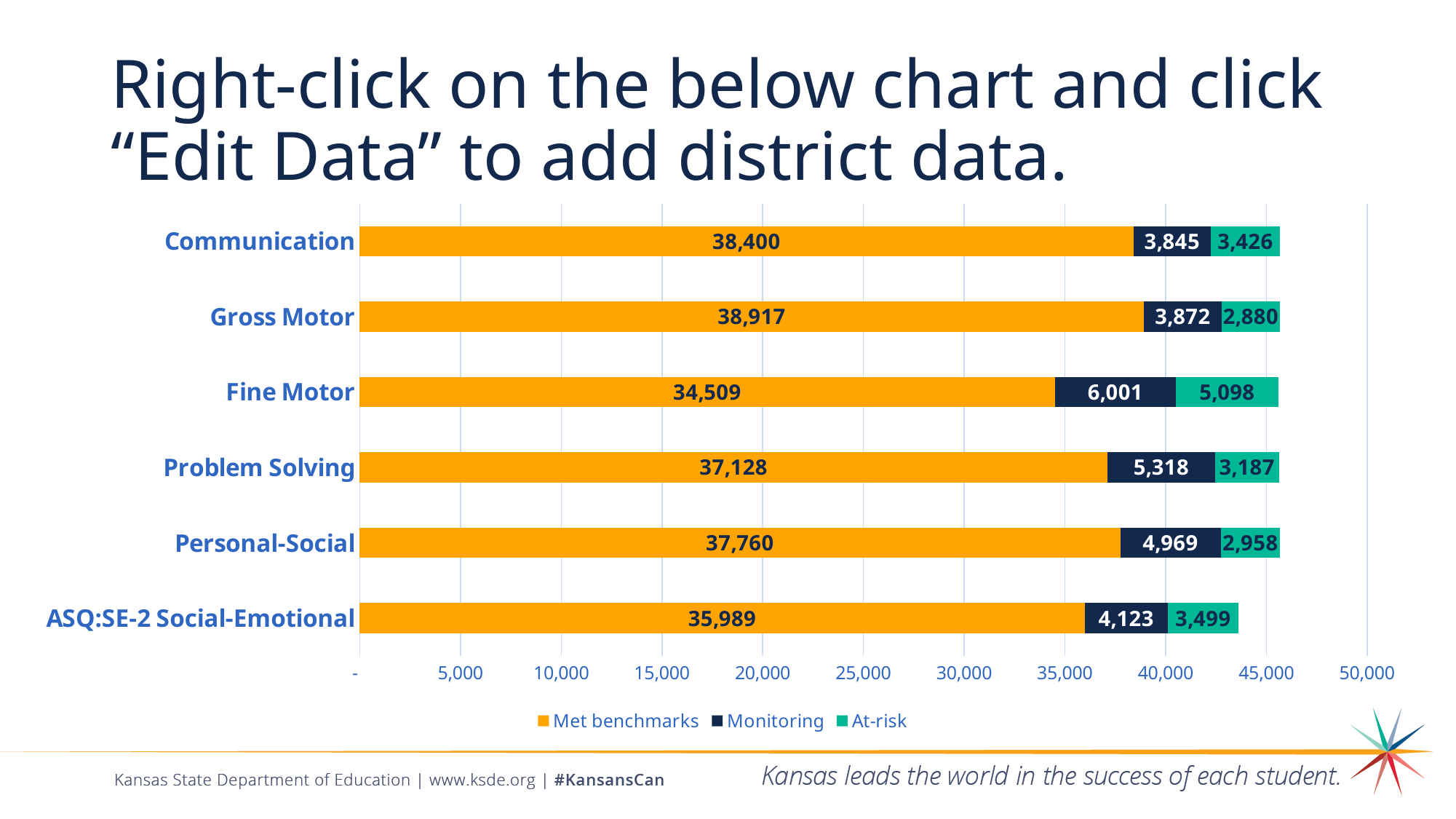
What is the Met benchmarks value for Fine Motor? 34,509 Which category has the lowest At-risk value? Gross Motor What is the At-risk value for ASQ:SE-2 Social-Emotional? 3,499 What is the Monitoring value for Problem Solving? 5,318 Which is larger, the At-risk value for Communication or the At-risk value for Personal-Social? Communication What is the total of the stacked bar for ASQ:SE-2 Social-Emotional? 43,611 What is the difference between the Monitoring values for Fine Motor and Communication? 2,156 How many series does the legend list? 3 What type of chart is shown on the slide? Stacked bar chart How many categories are shown on the chart? 6 Which series is shown in orange in the legend? Met benchmarks Which category has the highest Met benchmarks value? Gross Motor